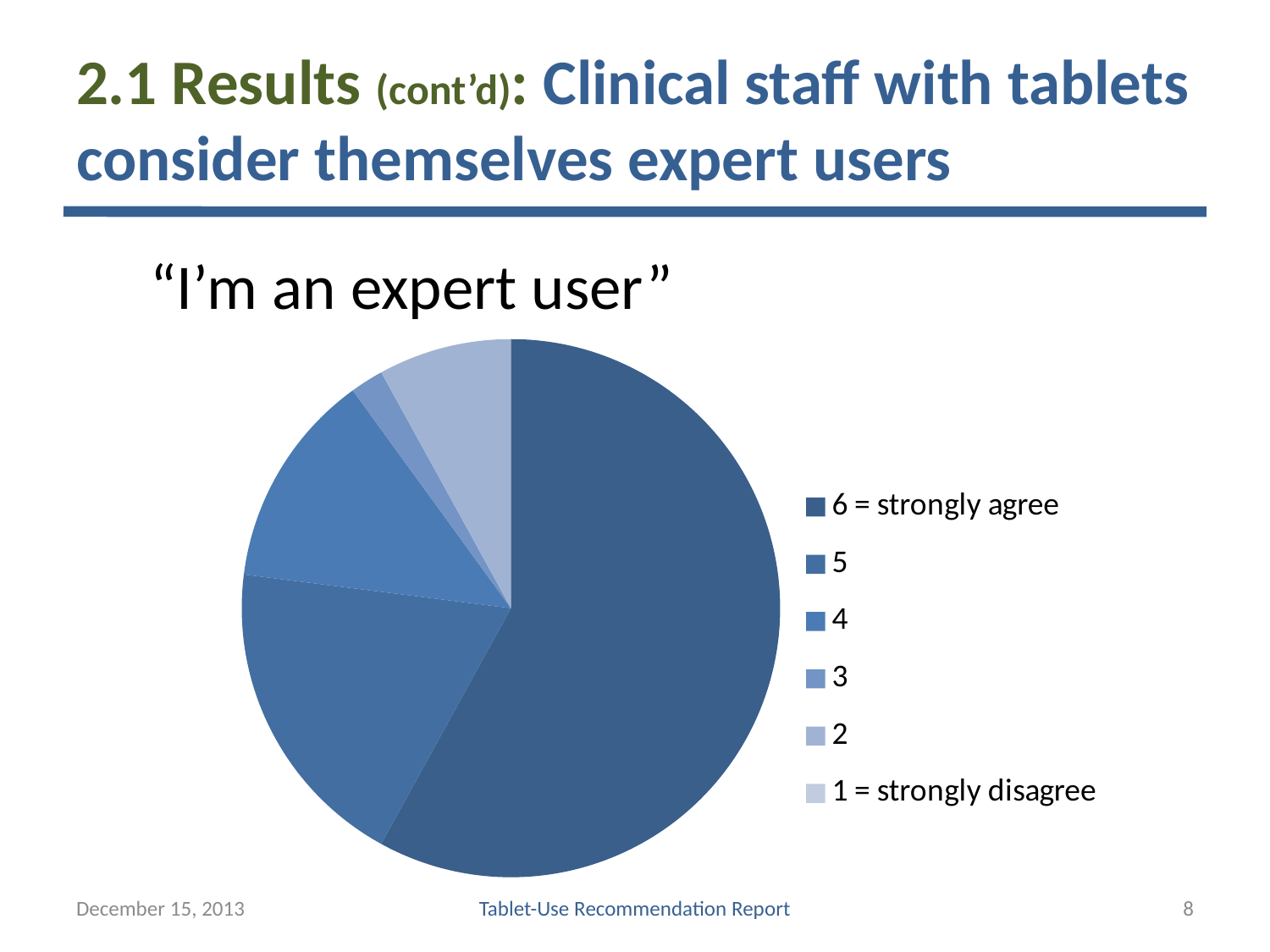
What does the legend label "1" stand for in the pie chart? strongly disagree Which slice is larger, "5" or "4"? 5 What is the title of the pie chart? "I'm an expert user" How many entries does the legend of the pie chart list? 6 Which slice is larger, "6 = strongly agree" or "5"? 6 = strongly agree Which category has the largest slice of the pie chart? 6 = strongly agree Which slice is larger, "4" or "3"? 4 What kind of chart is shown on the slide? pie chart Does the "6 = strongly agree" slice take up more or less than half of the pie? more